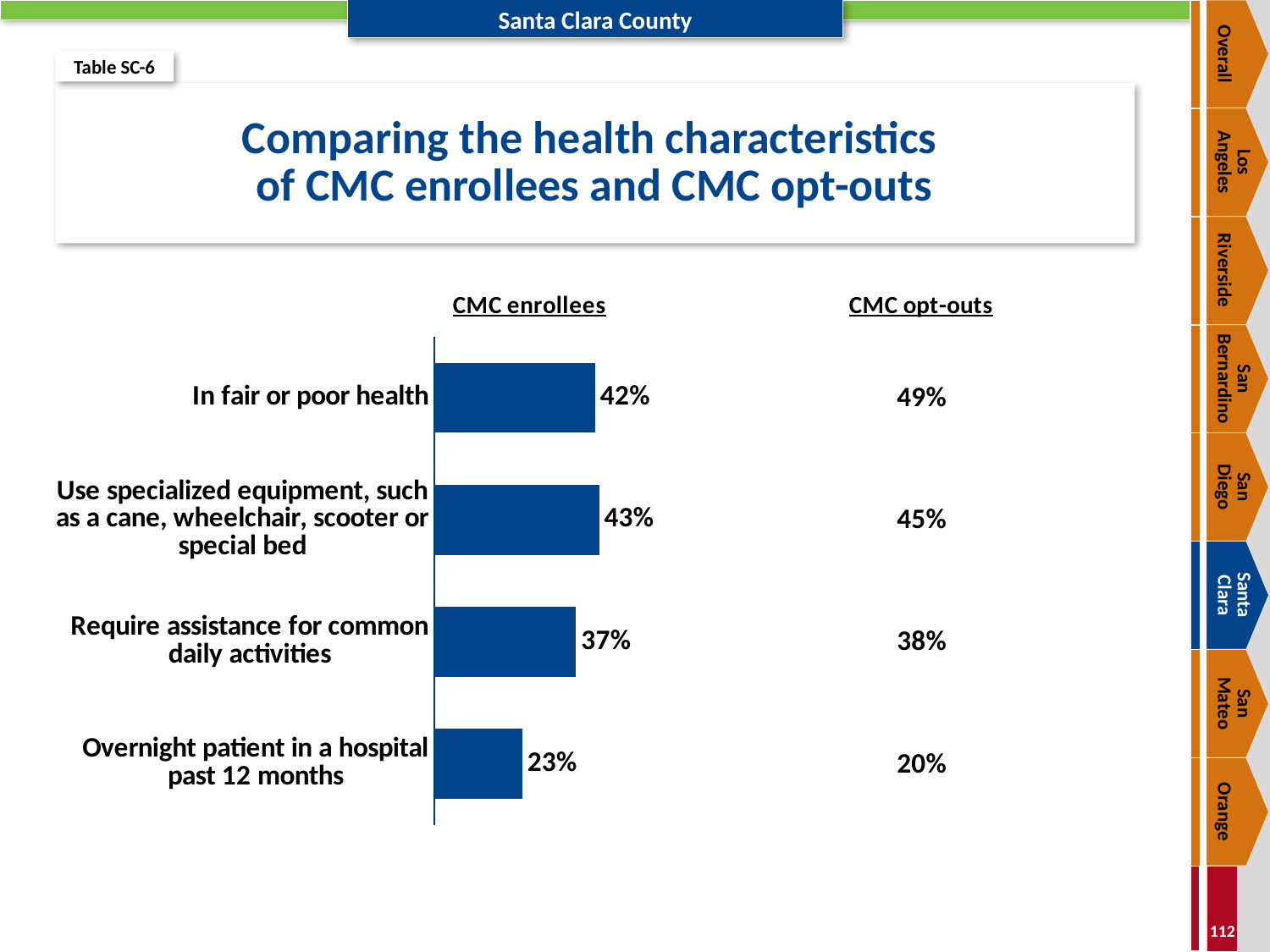
What percentage of CMC opt-outs require assistance for common daily activities? 38% What percentage of CMC enrollees are in fair or poor health? 42% Which health characteristic has the highest percentage among CMC enrollees? Use specialized equipment, such as a cane, wheelchair, scooter or special bed What is the title of the chart on the slide? Comparing the health characteristics of CMC enrollees and CMC opt-outs What type of chart is used to show the CMC enrollees values? Bar chart What percentage of CMC enrollees were an overnight patient in a hospital in the past 12 months? 23% What percentage of CMC enrollees use specialized equipment, such as a cane, wheelchair, scooter or special bed? 43% Which health characteristic has the lowest percentage among CMC enrollees? Overnight patient in a hospital past 12 months For overnight patient in a hospital past 12 months, which group has the larger percentage, CMC enrollees or CMC opt-outs? CMC enrollees What percentage of CMC opt-outs are in fair or poor health? 49% What is the difference between the CMC opt-outs and CMC enrollees percentages for being in fair or poor health? 7 percentage points How many health characteristics are compared on the slide? 4